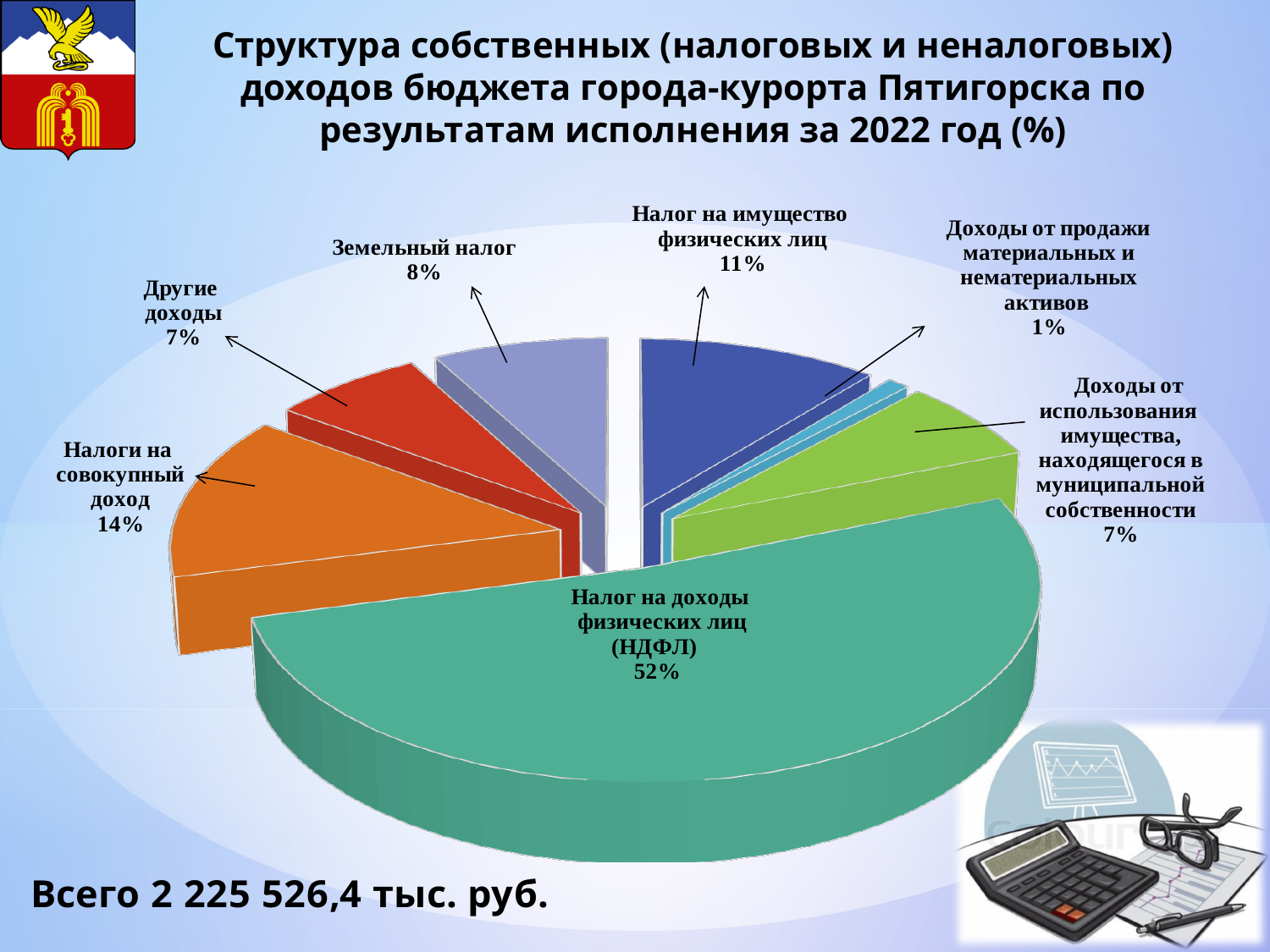
What is the share of Доходы от продажи материальных и нематериальных активов? 1% What share of the budget's own revenues does Налог на доходы физических лиц (НДФЛ) account for? 52% What is the share of Земельный налог? 8% What is the share of Налоги на совокупный доход? 14% Which is larger: the share of Налог на имущество физических лиц or the share of Земельный налог? Налог на имущество физических лиц What total amount of own revenues is stated on the slide? 2 225 526,4 тыс. руб. What kind of chart is shown on the slide? pie chart What is the difference in percentage points between Налоги на совокупный доход and Земельный налог? 6 Which category has the largest share of the pie? Налог на доходы физических лиц (НДФЛ) What is the share of Налог на имущество физических лиц? 11% Which category has the smallest share of the pie? Доходы от продажи материальных и нематериальных активов How many slices does the pie chart have? 7